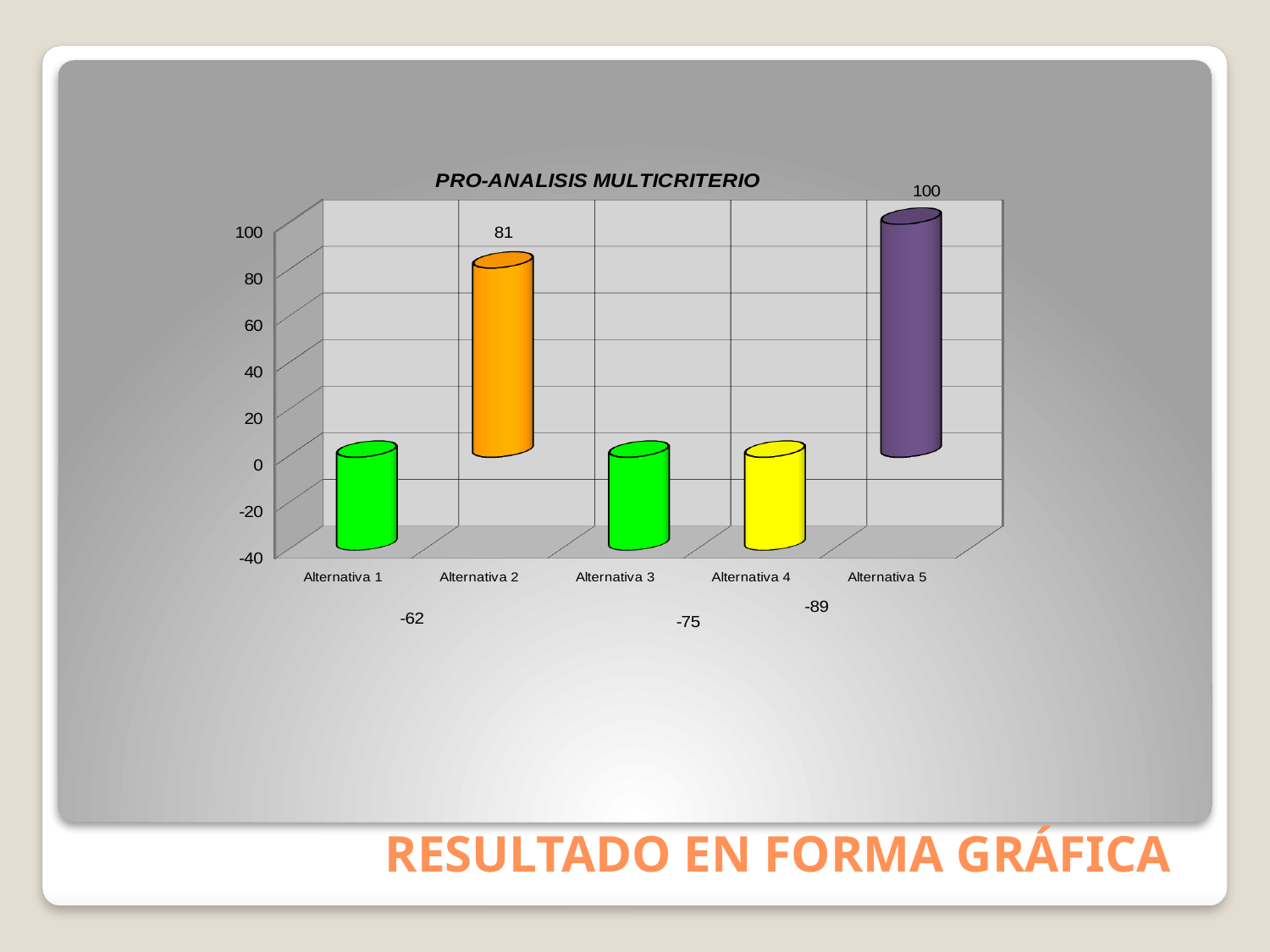
Which alternative has the highest value? Alternativa 5 What colour is the bar for Alternativa 4? Yellow What is the value for Alternativa 1? -62 How many alternatives are shown on the chart? 5 What is the value for Alternativa 2? 81 What is the title of the chart? PRO-ANALISIS MULTICRITERIO What kind of chart is shown on the slide? Bar chart What is the difference between the values for Alternativa 5 and Alternativa 2? 19 What is the value for Alternativa 5? 100 What is the value for Alternativa 4? -89 Which has the larger value, Alternativa 1 or Alternativa 3? Alternativa 1 Which alternative has the lowest value? Alternativa 4